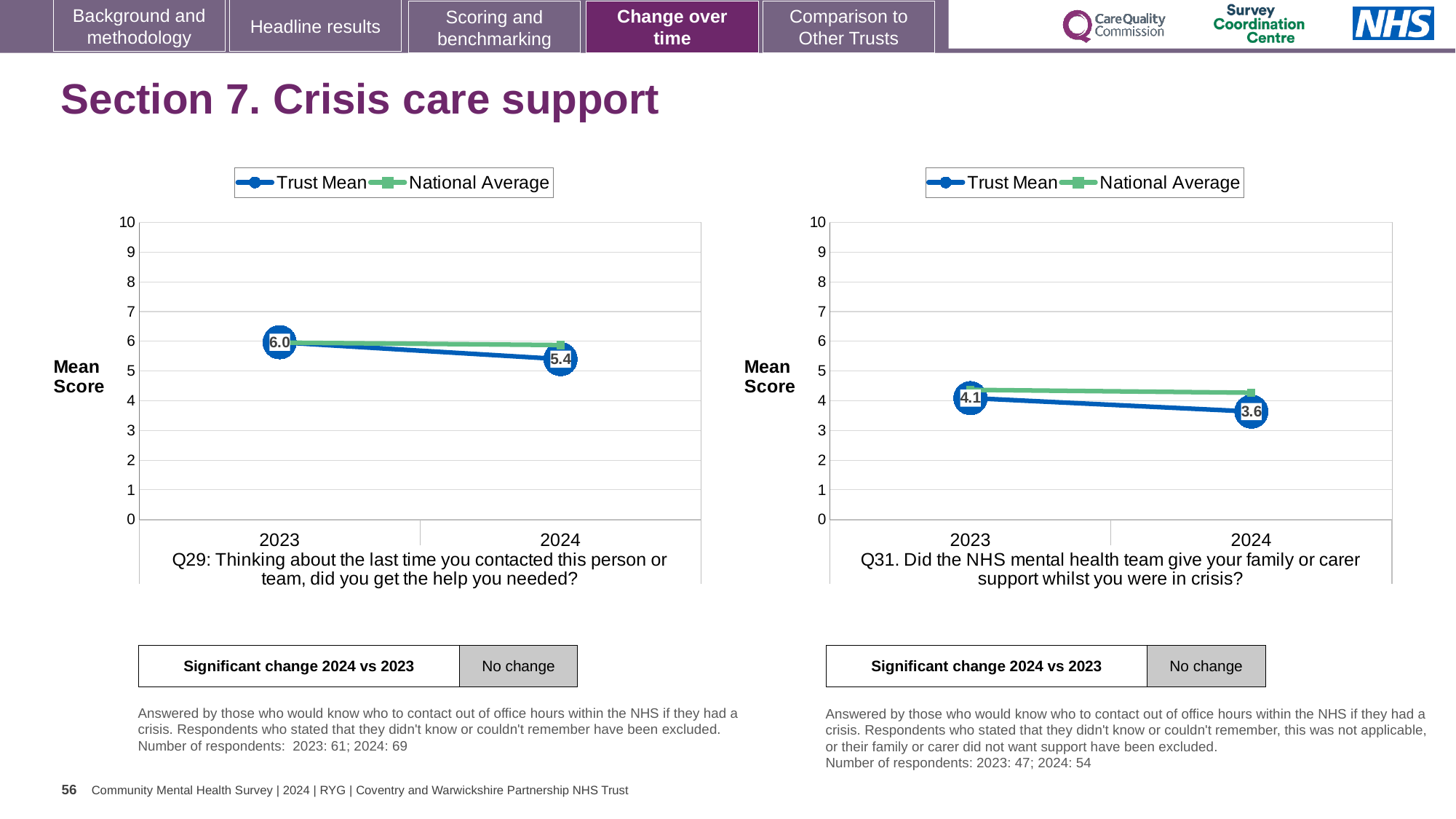
In the Q31 chart on the right, what is the Trust Mean for 2023? 4.1 What kind of chart is the Q29 chart on the left? line chart In the Q29 chart on the left, what is the Trust Mean for 2023? 6.0 In the Q31 chart on the right, what is the difference between the Trust Mean in 2023 and in 2024? 0.5 In the Q31 chart on the right, which year has the higher Trust Mean, 2023 or 2024? 2023 In the Q29 chart on the left, by how much did the Trust Mean fall from 2023 to 2024? 0.6 How many years are shown on the x axis of the Q29 chart on the left? 2 In the Q29 chart on the left, does the Trust Mean rise or fall from 2023 to 2024? fall In the Q31 chart on the right, is the National Average for 2024 greater or less than 5? less In the Q31 chart on the right, what is the Trust Mean for 2024? 3.6 How many series does the legend of the Q31 chart on the right list? 2 In the Q29 chart on the left, what is the Trust Mean for 2024? 5.4